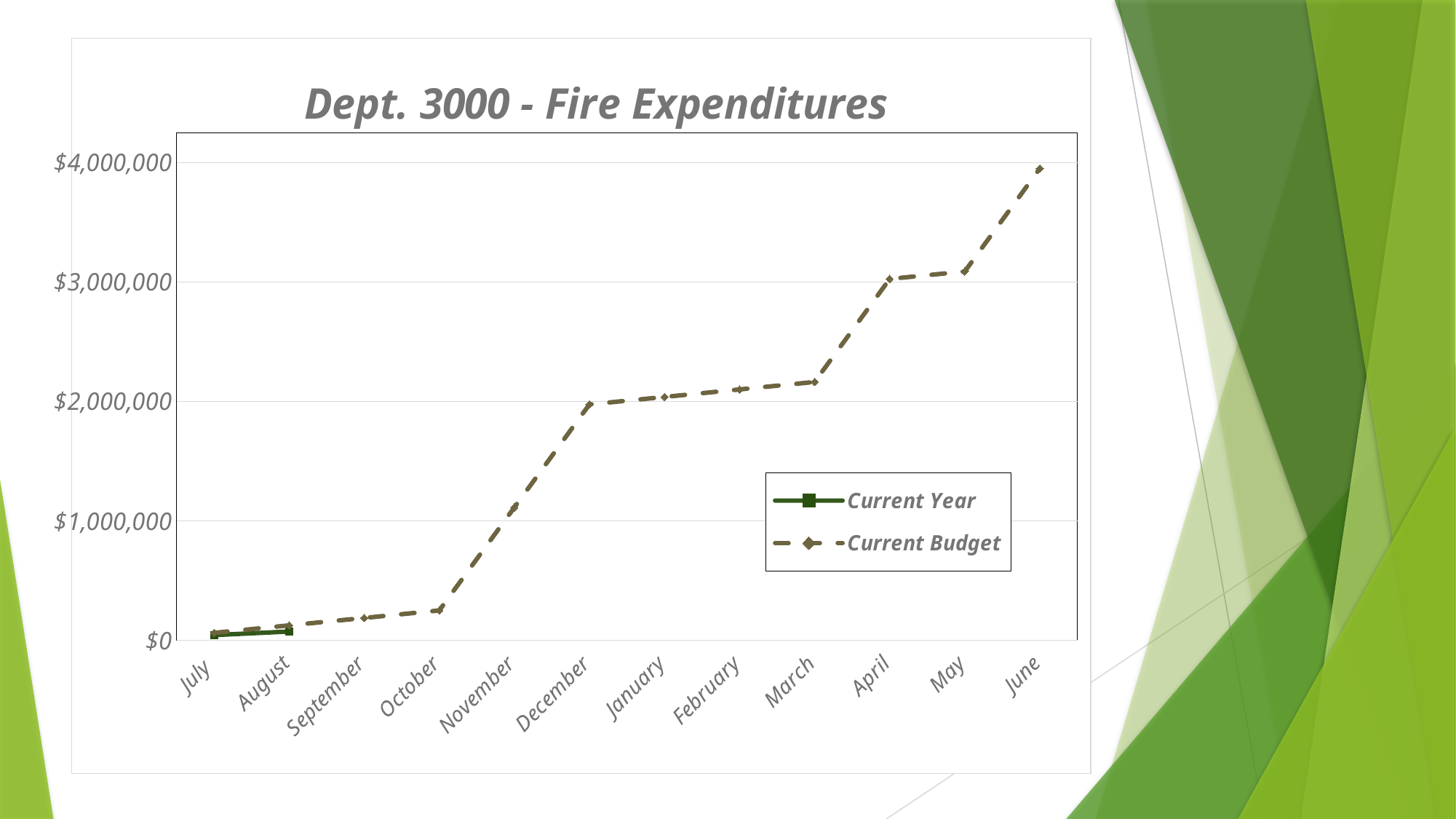
Is the Current Budget value for June greater or less than $3,000,000? greater How many series does the legend list? 2 Is the Current Budget value for February greater or less than $2,000,000? greater What is the title of the chart? Dept. 3000 - Fire Expenditures In which month is the Current Budget value highest? June What kind of chart is shown on the slide? line chart How many months are shown on the x axis? 12 Does the Current Budget line rise or fall from July to June? rise In August, which series has the larger value, Current Year or Current Budget? Current Budget Which two series are listed in the legend? Current Year and Current Budget In which month is the Current Budget value lowest? July Is the Current Budget value for October greater or less than $1,000,000? less